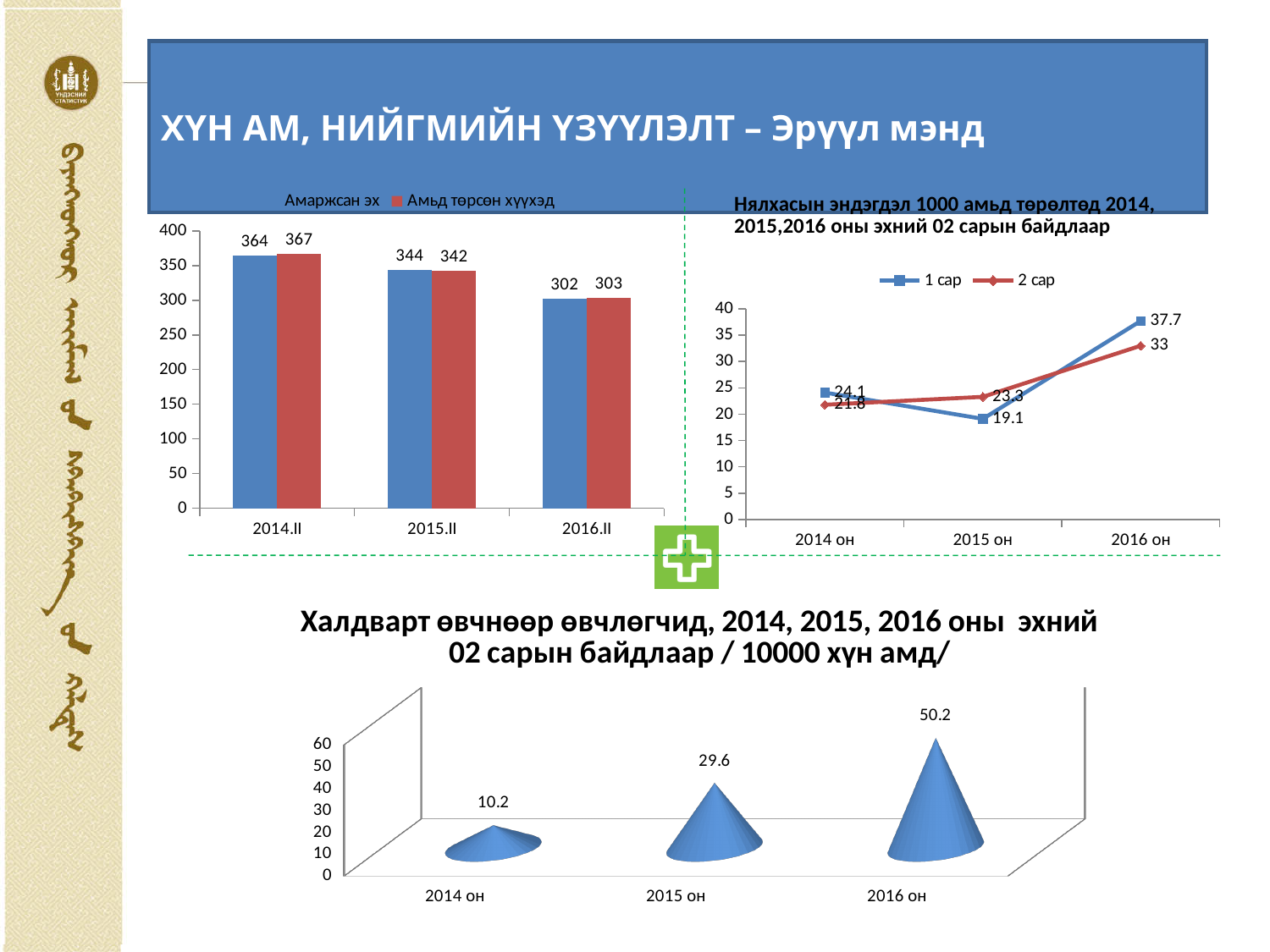
In the top-left bar chart, do the values for Амаржсан эх rise or fall from 2014.II to 2016.II? fall In the bottom chart titled 'Халдварт өвчнөөр өвчлөгчид...', what is the value for 2015 он? 29.6 In the top-left bar chart, what is the value for Амьд төрсөн хүүхэд in 2016.II? 303 In the chart titled 'Нялхасын эндэгдэл 1000 амьд төрөлтөд...', which is larger in 2015 он, 1 сар or 2 сар? 2 сар In the chart titled 'Нялхасын эндэгдэл 1000 амьд төрөлтөд...', what is the value for 2 сар in 2015 он? 23.3 In the chart titled 'Нялхасын эндэгдэл 1000 амьд төрөлтөд...', what is the value for 1 сар in 2016 он? 37.7 In the bottom chart titled 'Халдварт өвчнөөр өвчлөгчид...', what is the difference between 2016 он and 2014 он? 40 In the top-left bar chart, how many series does the legend list? 2 In the top-left bar chart, what is the difference between Амьд төрсөн хүүхэд and Амаржсан эх in 2014.II? 3 In the top-left bar chart, what is the value for Амаржсан эх in 2014.II? 364 In the top-left bar chart, which period has the lowest value for Амаржсан эх? 2016.II In the chart titled 'Нялхасын эндэгдэл 1000 амьд төрөлтөд...', what kind of chart is it? line chart